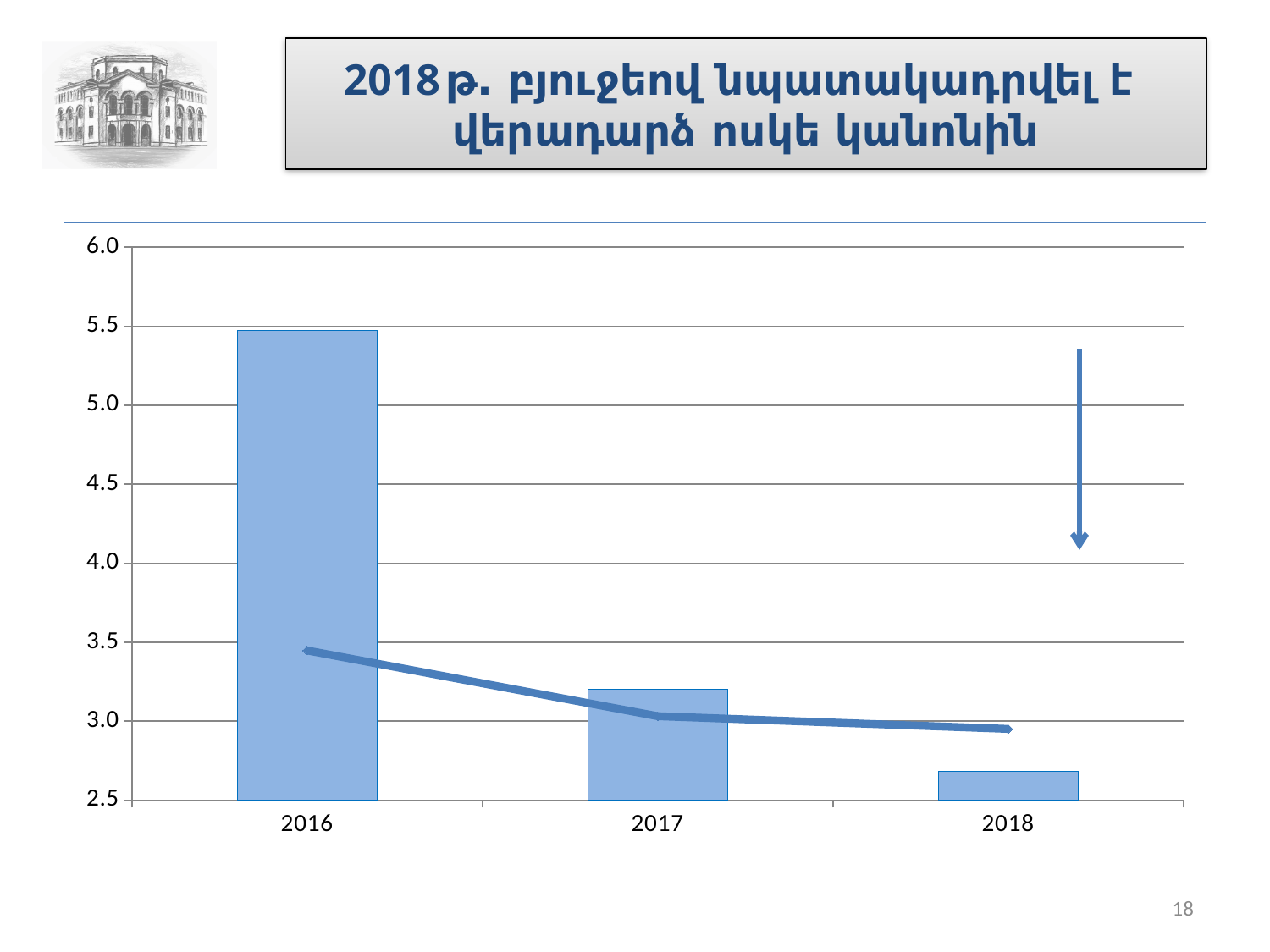
Do the bar values rise or fall from 2016 to 2018? fall Is the value for 2016 greater or less than 5.0? greater What is the lowest value shown on the y axis of the chart? 2.5 Which year has the highest bar in the chart? 2016 In which direction does the large arrow drawn on the right side of the chart point? down Which year has the lowest bar in the chart? 2018 What kind of chart is shown on the slide? bar and line chart Is the value for 2018 greater or less than 3.0? less Which is larger, the value for 2017 or the value for 2018? 2017 Is the value for 2017 greater or less than 3.0? greater How many years are shown on the x axis of the chart? 3